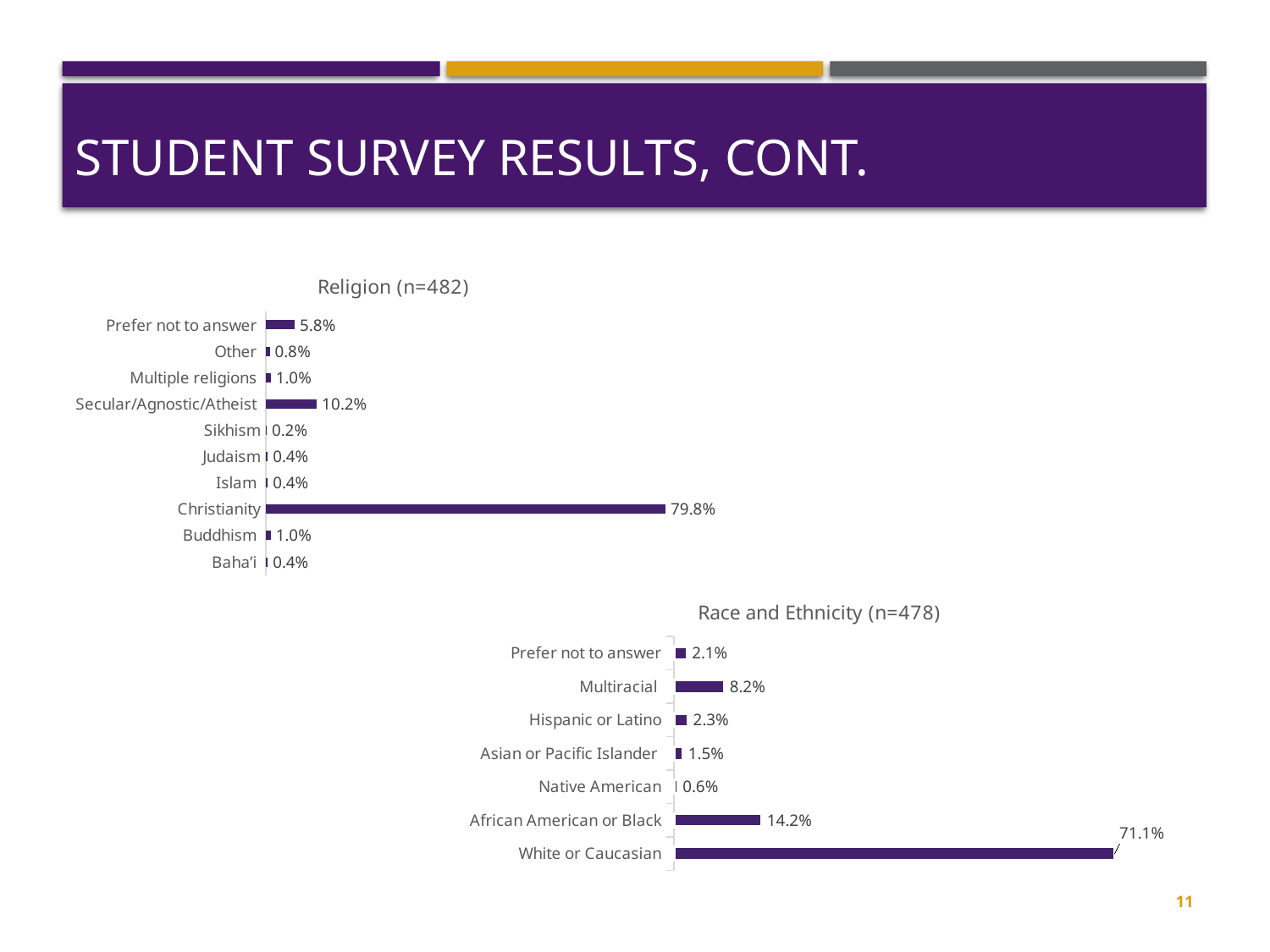
In the Race and Ethnicity (n=478) chart, what is the value for African American or Black? 14.2% In the Religion (n=482) chart, which category has the highest value? Christianity What type of chart is the Race and Ethnicity (n=478) chart? Bar chart In the Race and Ethnicity (n=478) chart, what is the value for Multiracial? 8.2% In the Religion (n=482) chart, what is the value for Christianity? 79.8% In the Race and Ethnicity (n=478) chart, how many categories are shown? 7 In the Religion (n=482) chart, which category has the lowest value? Sikhism In the Religion (n=482) chart, what is the value for Secular/Agnostic/Atheist? 10.2% In the Race and Ethnicity (n=478) chart, which is larger, Hispanic or Latino or Asian or Pacific Islander? Hispanic or Latino In the Race and Ethnicity (n=478) chart, which category has the lowest value? Native American In the Religion (n=482) chart, what is the difference between Secular/Agnostic/Atheist and Prefer not to answer? 4.4% In the Religion (n=482) chart, how many categories are shown? 10